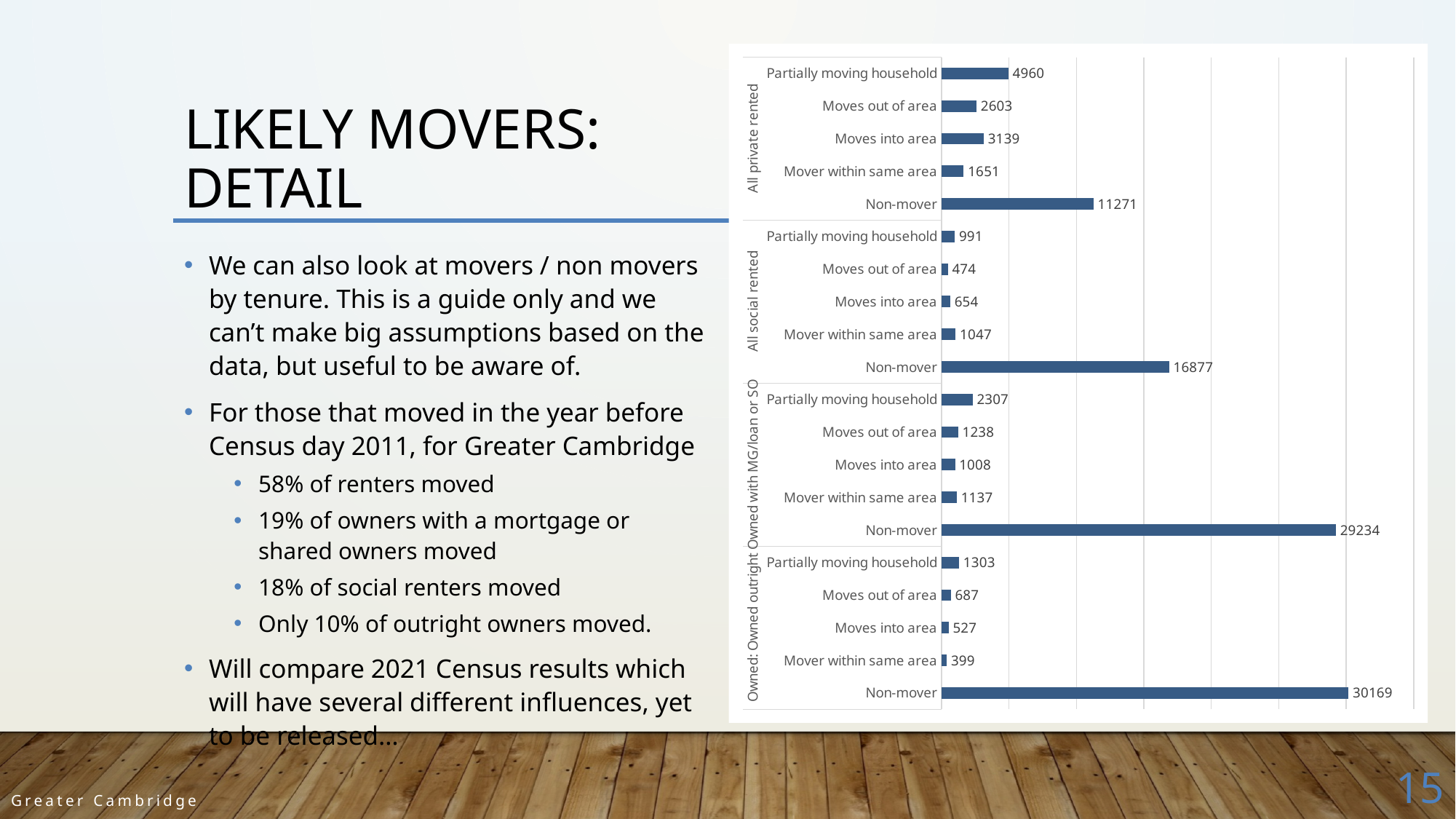
What is the value for Partially moving household in the Owned with MG/loan or SO group? 2307 Which is larger: Non-mover in All social rented or Non-mover in Owned with MG/loan or SO? Non-mover in Owned with MG/loan or SO Which bar has the highest value on the chart? Non-mover (Owned: Owned outright) Which is larger: Moves out of area in All private rented or Moves into area in All private rented? Moves into area What is the value for Moves into area in the All social rented group? 654 What kind of chart is shown on the slide? Bar chart What is the difference between Non-mover and Partially moving household in the All private rented group? 6311 How many tenure groups are shown on the chart's vertical axis? 4 How many bars are plotted on the chart? 20 What is the value for Mover within same area in the Owned: Owned outright group? 399 What is the value for Non-mover in the All private rented group? 11271 Which bar has the lowest value on the chart? Mover within same area (Owned: Owned outright)